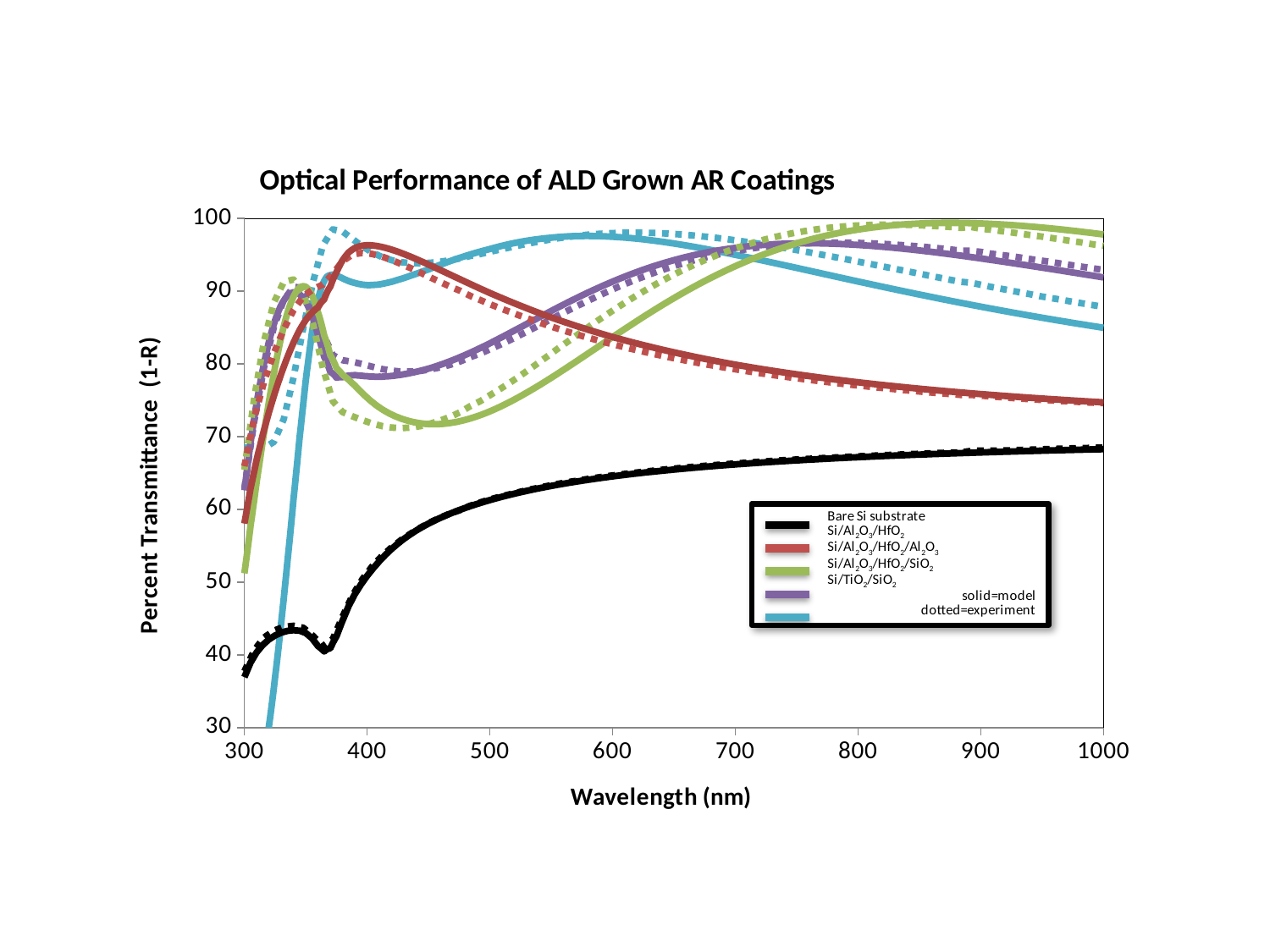
Is the value for Si/Al2O3/HfO2/Al2O3 at 900 nm greater or less than 90? greater According to the legend, what do the dotted lines represent? experiment Is the value for Si/Al2O3/HfO2 at 1000 nm greater or less than 80? less What is the title of the chart? Optical Performance of ALD Grown AR Coatings Does the Si/Al2O3/HfO2 curve rise or fall from 400 nm to 1000 nm? fall Which series has the lowest transmittance at 1000 nm? Bare Si substrate What kind of chart is shown on the slide? line chart Is the value for the Bare Si substrate at 1000 nm greater or less than 70? less Does the Bare Si substrate curve rise or fall from 400 nm to 1000 nm? rise How many series does the legend list? 5 At 1000 nm, which has the higher transmittance: Si/Al2O3/HfO2/Al2O3 or Si/Al2O3/HfO2? Si/Al2O3/HfO2/Al2O3